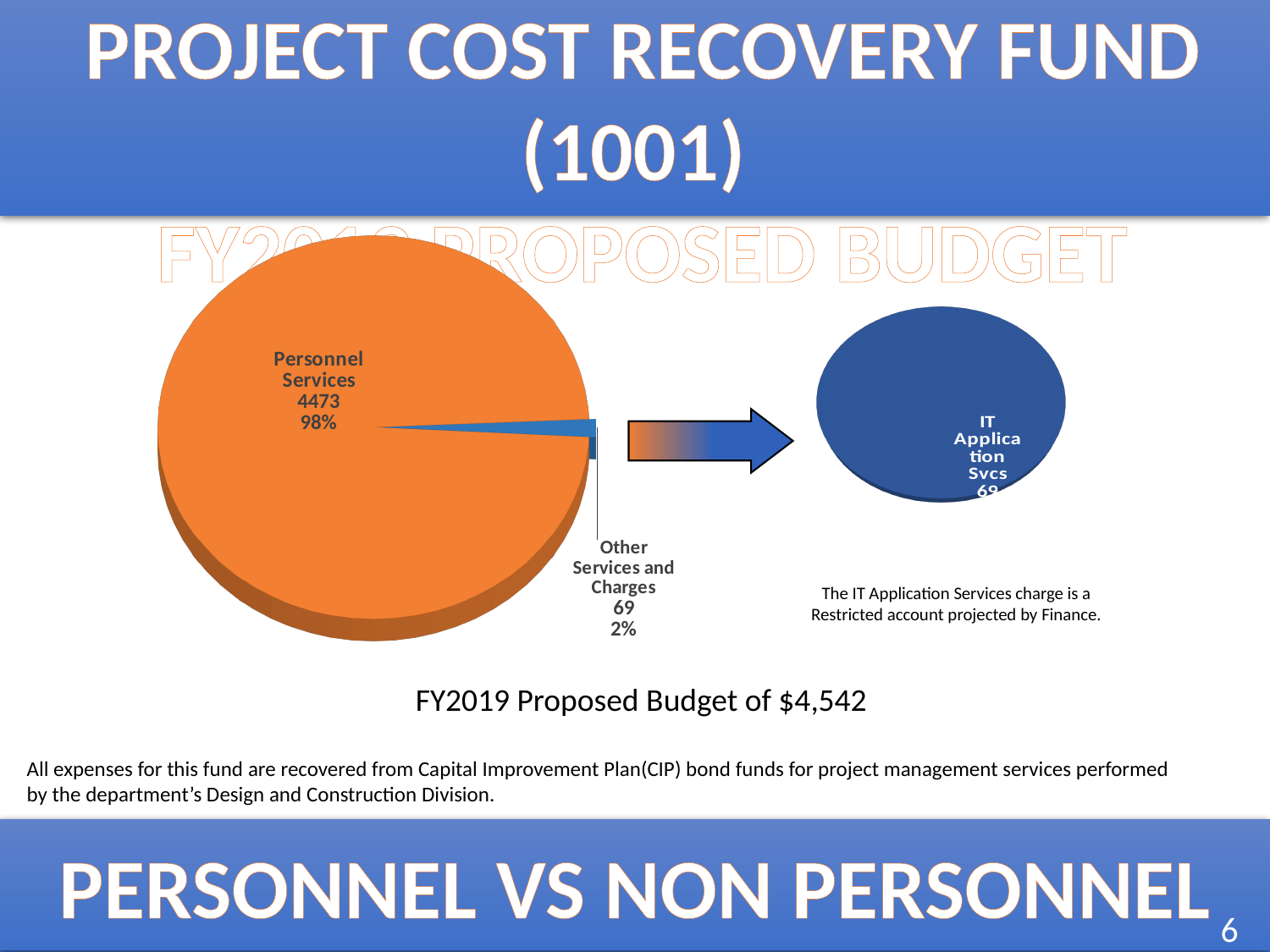
In the left pie chart, which category is the smallest? Other Services and Charges What kind of chart is the large chart on the left of the slide? Pie chart In the left pie chart, what colour is the Personnel Services slice? Orange In the left pie chart, what share of the pie is Other Services and Charges? 2% In the left pie chart, what share of the pie is Personnel Services? 98% In the left pie chart, what is the value for Other Services and Charges? 69 In the left pie chart, what is the difference between the Personnel Services value and the Other Services and Charges value? 4404 In the left pie chart, what is the value for Personnel Services? 4473 What category is labelled in the small pie chart on the right of the slide? IT Application Svcs How many categories does the left pie chart show? 2 In the left pie chart, which is larger: Personnel Services or Other Services and Charges? Personnel Services In the left pie chart, which category is the largest? Personnel Services